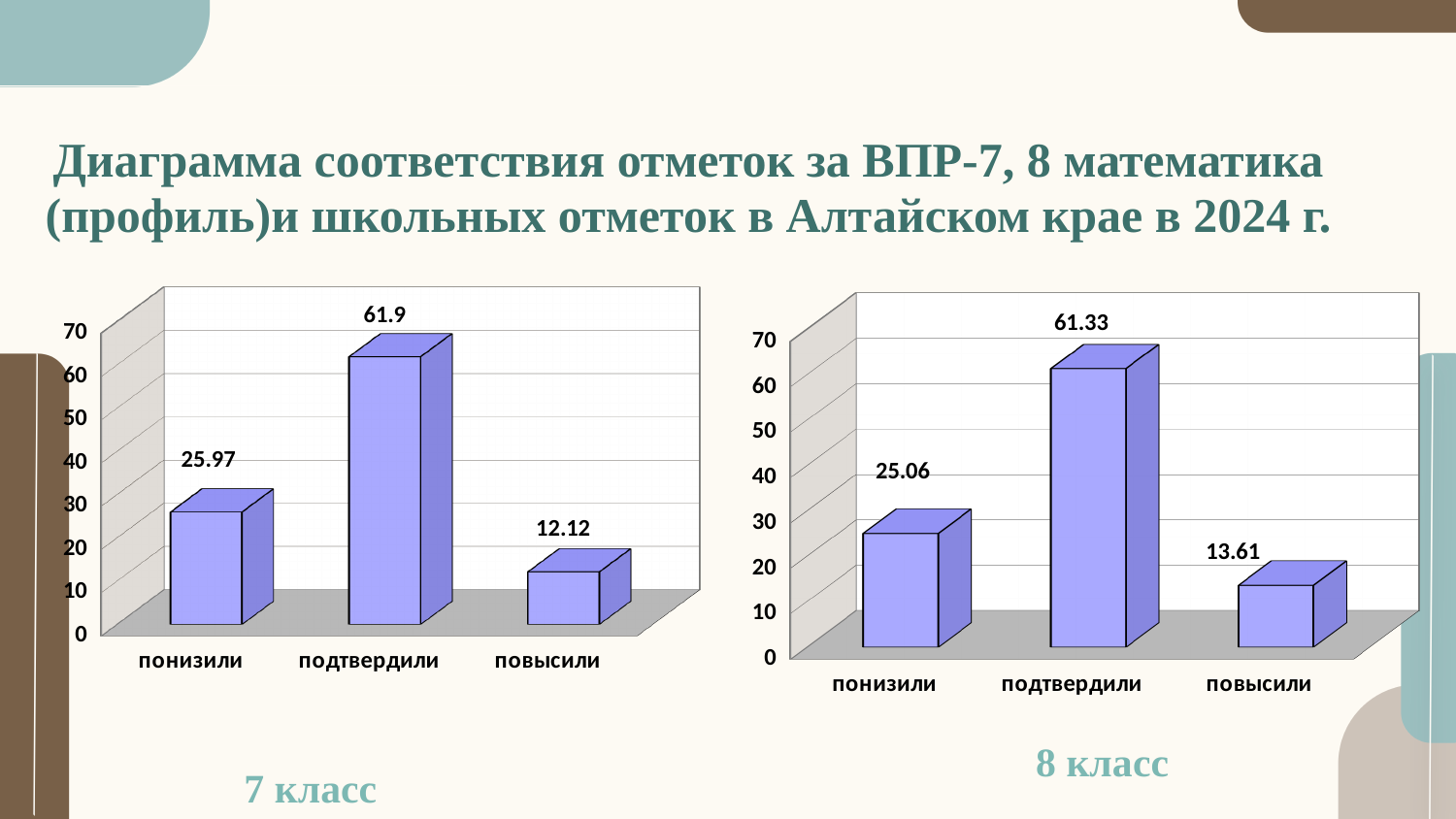
How many categories are shown in the left chart (7 класс)? 3 What kind of chart is the right chart (8 класс)? bar chart In the left chart (7 класс), what is the value for подтвердили? 61.9 In the left chart (7 класс), is the value for повысили greater or less than 20? less In the left chart (7 класс), what is the value for понизили? 25.97 In the right chart (8 класс), what is the value for подтвердили? 61.33 In the left chart (7 класс), what is the difference between the values for подтвердили and понизили? 35.93 In the left chart (7 класс), which category has the highest value? подтвердили In the right chart (8 класс), what is the value for повысили? 13.61 In the right chart (8 класс), which category has the lowest value? повысили In the right chart (8 класс), what is the difference between the values for понизили and повысили? 11.45 In the right chart (8 класс), which is larger: the value for понизили or the value for повысили? понизили